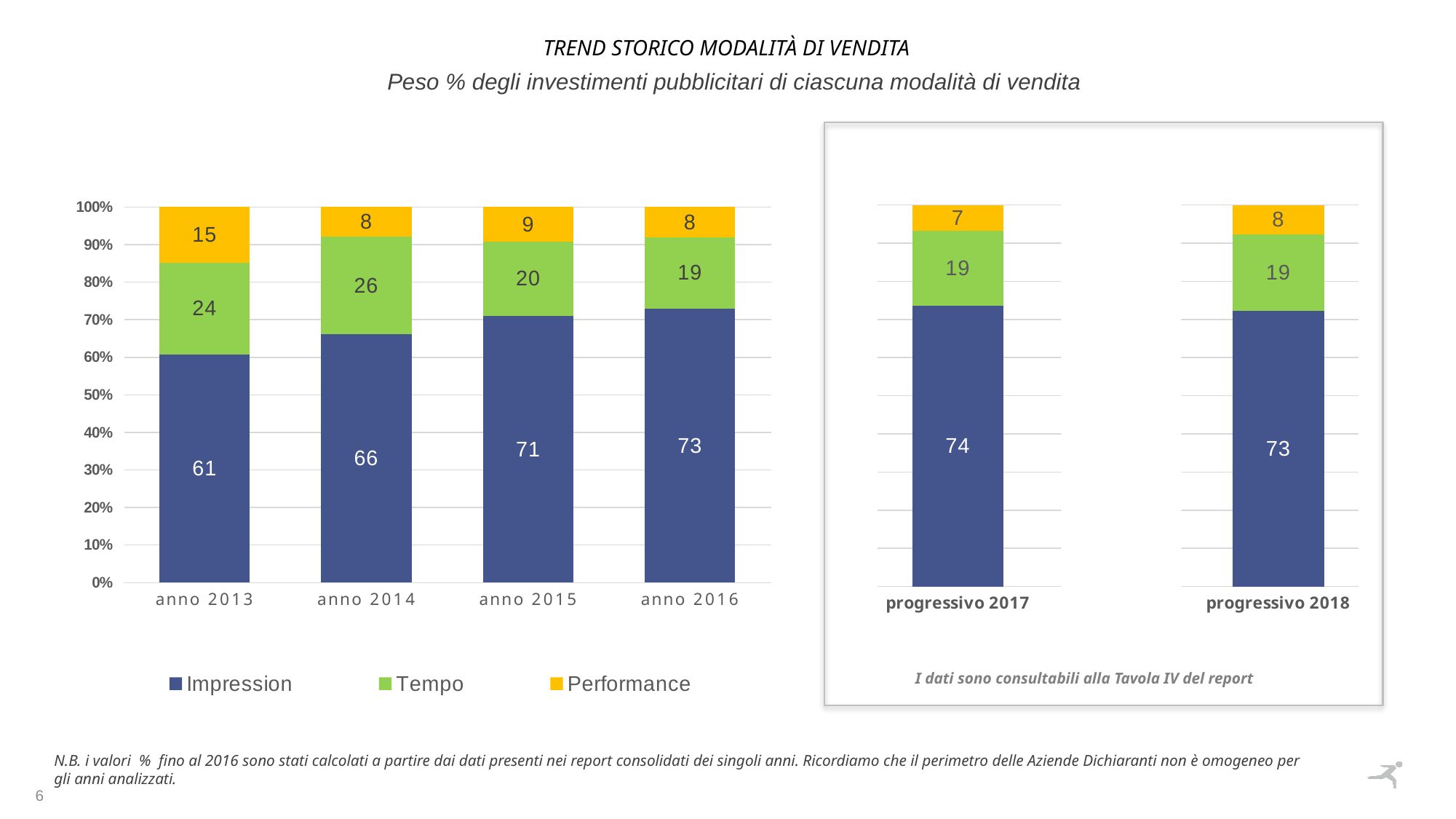
In the left chart, which year has the highest Impression value? anno 2016 In the left chart, is the Tempo value for anno 2013 larger or smaller than the Tempo value for anno 2015? larger In the left chart, what is the Performance value for anno 2015? 9 How many series does the legend list? 3 In the right chart, what is the Impression value for progressivo 2017? 74 In the left chart, which year has the lowest Performance value? anno 2014 and anno 2016 In the right chart, what is the Performance value for progressivo 2018? 8 In the left chart, what is the difference between the Impression values for anno 2016 and anno 2013? 12 In the left chart, does the Impression value rise or fall from anno 2013 to anno 2016? rise In the left chart, what is the Impression value for anno 2013? 61 In the left chart, what is the Tempo value for anno 2014? 26 What kind of chart is the left chart? stacked bar chart